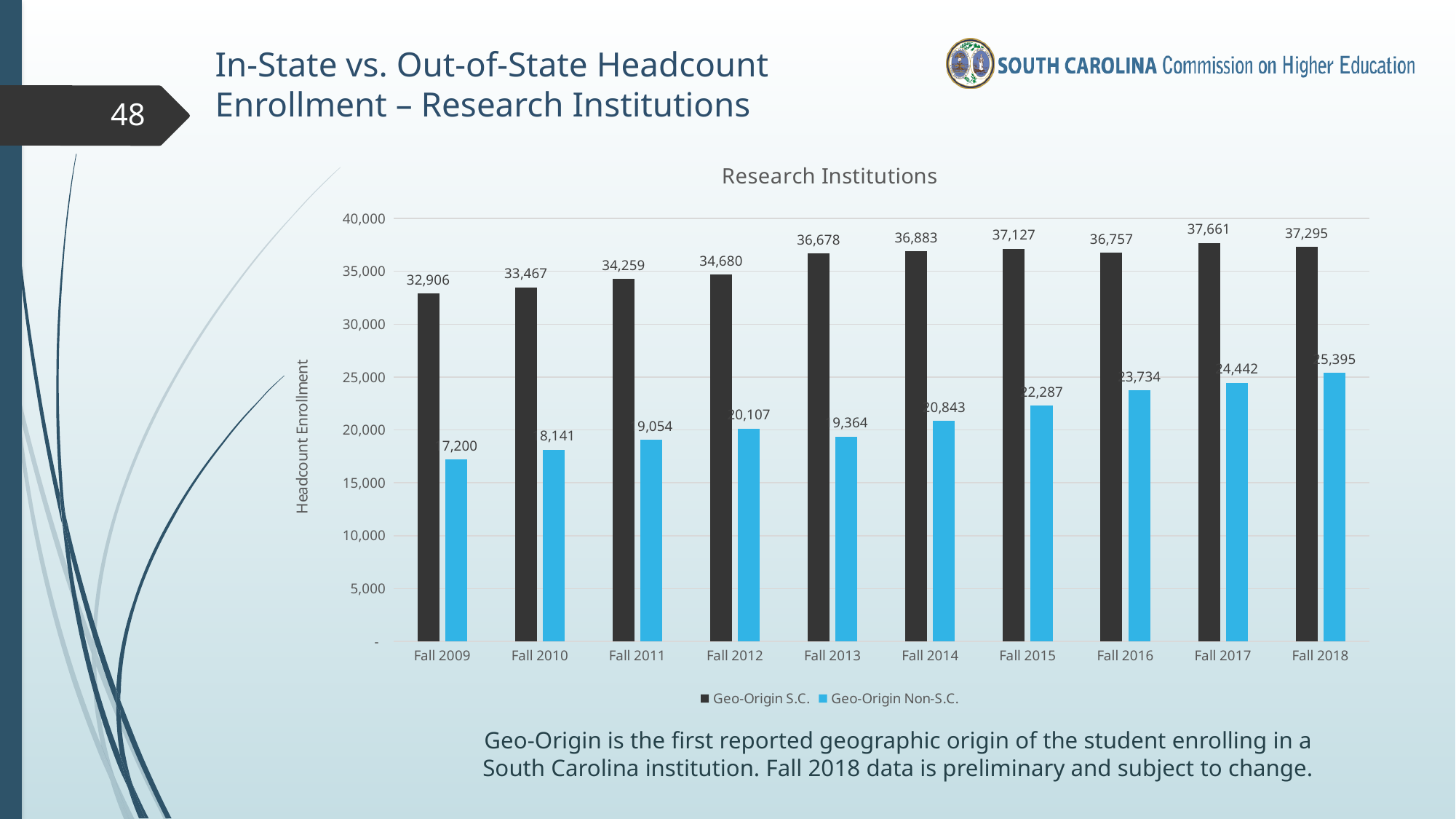
In which fall term is the Geo-Origin Non-S.C. headcount enrollment lowest? Fall 2009 How many fall terms are shown on the x axis of the chart? 10 Which is larger in Fall 2017: the Geo-Origin S.C. or the Geo-Origin Non-S.C. headcount enrollment? Geo-Origin S.C. What is the Geo-Origin S.C. headcount enrollment for Fall 2015? 37,127 How many series does the chart legend list? 2 What is the Geo-Origin S.C. headcount enrollment for Fall 2009? 32,906 What is the difference between the Geo-Origin S.C. and Geo-Origin Non-S.C. headcount enrollment in Fall 2018? 11,900 Does the Geo-Origin Non-S.C. headcount enrollment generally rise or fall from Fall 2009 to Fall 2018? rise Is the Geo-Origin Non-S.C. headcount enrollment for Fall 2009 greater or less than 20,000? less What is the Geo-Origin Non-S.C. headcount enrollment for Fall 2016? 23,734 What is the Geo-Origin Non-S.C. headcount enrollment for Fall 2018? 25,395 In which fall term is the Geo-Origin S.C. headcount enrollment highest? Fall 2017